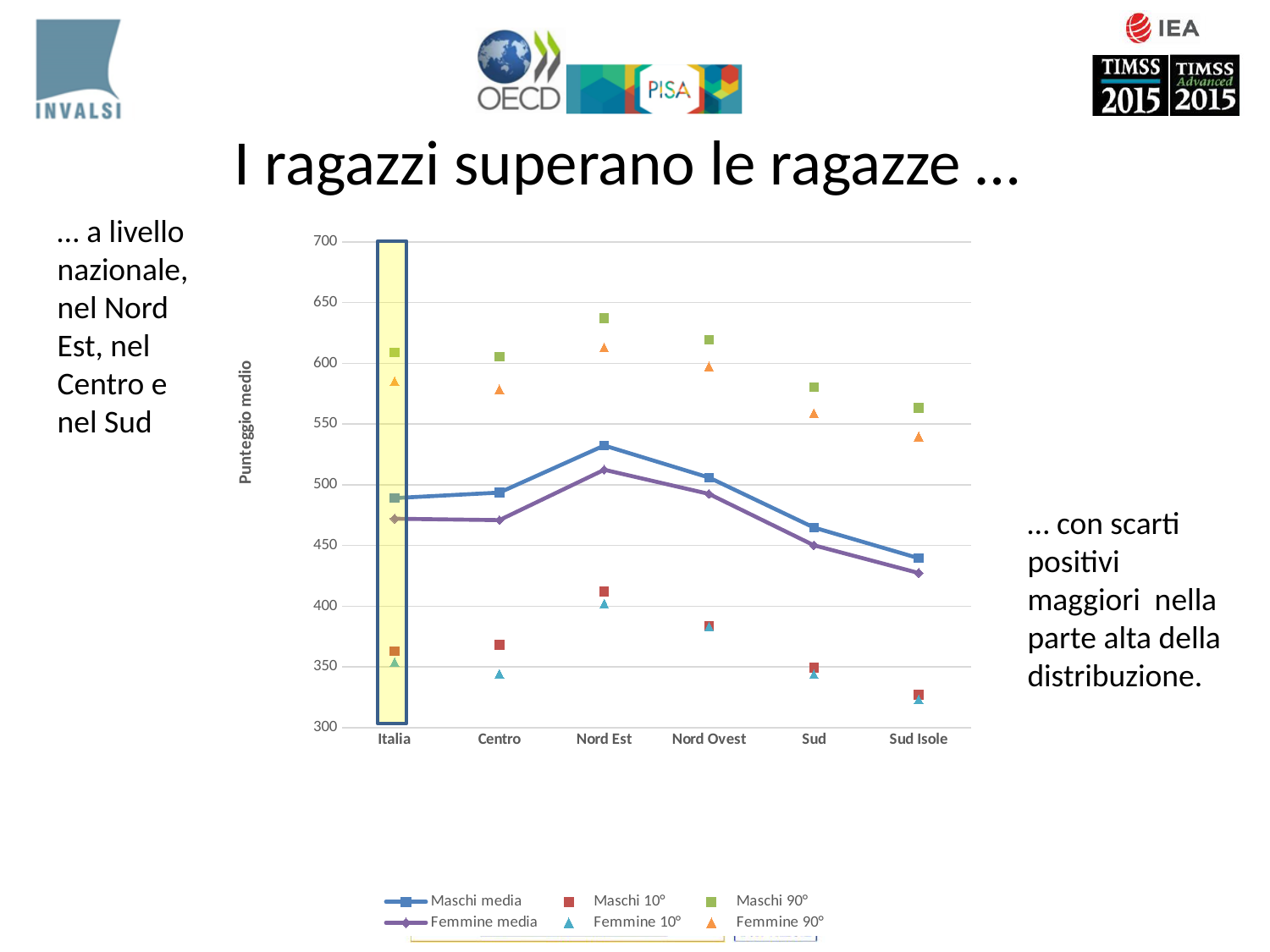
What is the label of the vertical axis of the chart? Punteggio medio Does the Maschi media series rise or fall from Nord Est to Sud Isole? fall What kind of chart is shown on the slide? line chart In which category does the Femmine media series reach its lowest value? Sud Isole Is the Maschi media value for Nord Est greater or less than 500? greater Is the Maschi 90° value for Nord Est greater or less than 600? greater Is the Femmine media value for Sud Isole greater or less than 450? less At Nord Est, which is larger: Maschi media or Femmine media? Maschi media In which category does the Maschi media series reach its highest value? Nord Est How many categories are shown on the x axis of the chart? 6 How many series does the chart legend list? 6